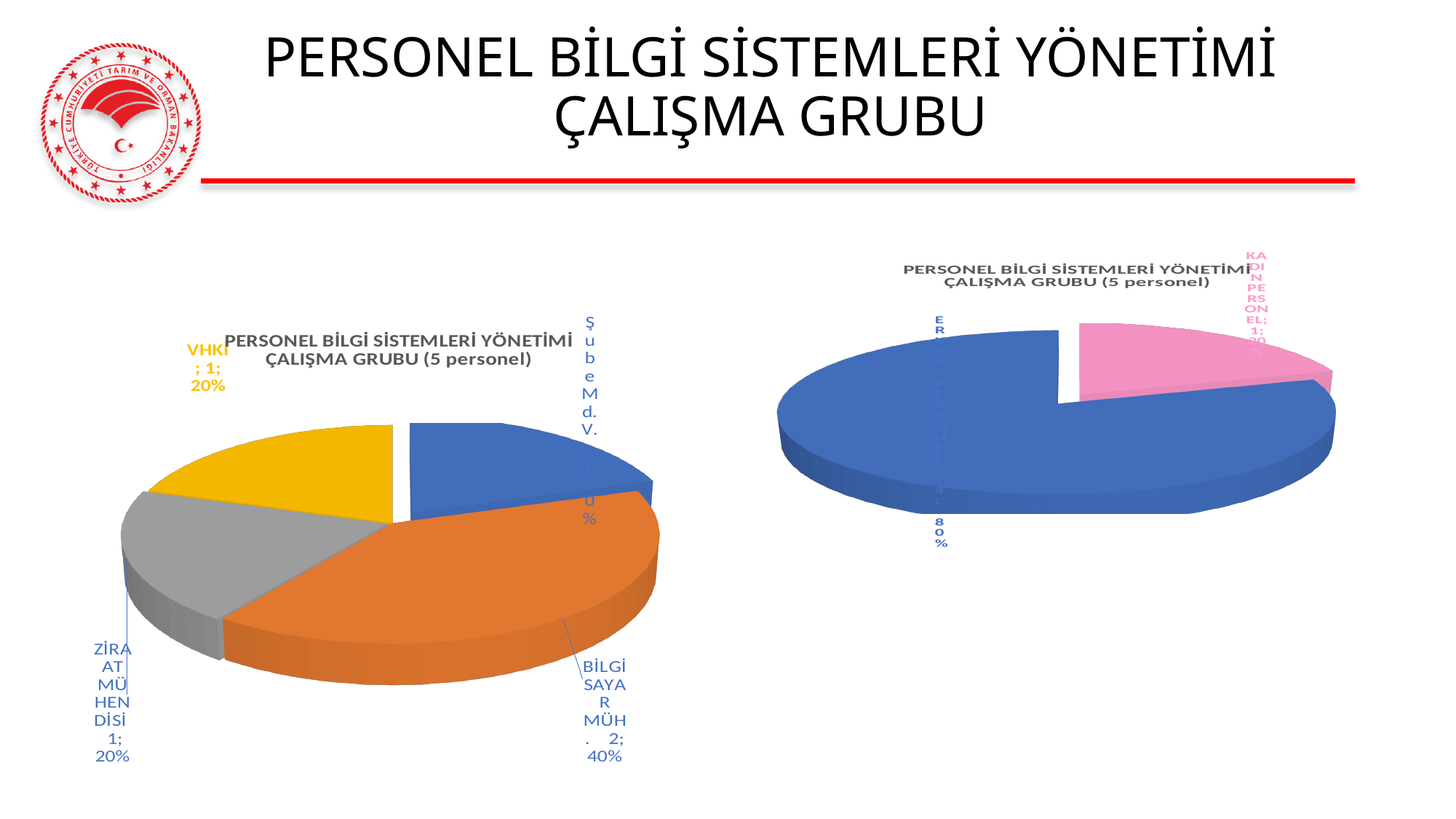
According to the chart titles, how many personnel are in the working group? 5 In the left pie chart, what share does VHKİ have? 20% In the left pie chart, which category has the largest slice? BİLGİSAYAR MÜH. In the left pie chart, how many personnel are ZİRAAT MÜHENDİSİ? 1 In the left pie chart, how many slices are there? 4 In the right pie chart, which category has the larger slice, ERKEK PERSONEL or KADIN PERSONEL? ERKEK PERSONEL What type of chart is the left chart on the slide? pie chart In the right pie chart, how many slices are there? 2 In the left pie chart, how many personnel are BİLGİSAYAR MÜH.? 2 In the left pie chart, what share does BİLGİSAYAR MÜH. have? 40% In the right pie chart, what share does KADIN PERSONEL have? 20% In the right pie chart, how many personnel are ERKEK PERSONEL? 4